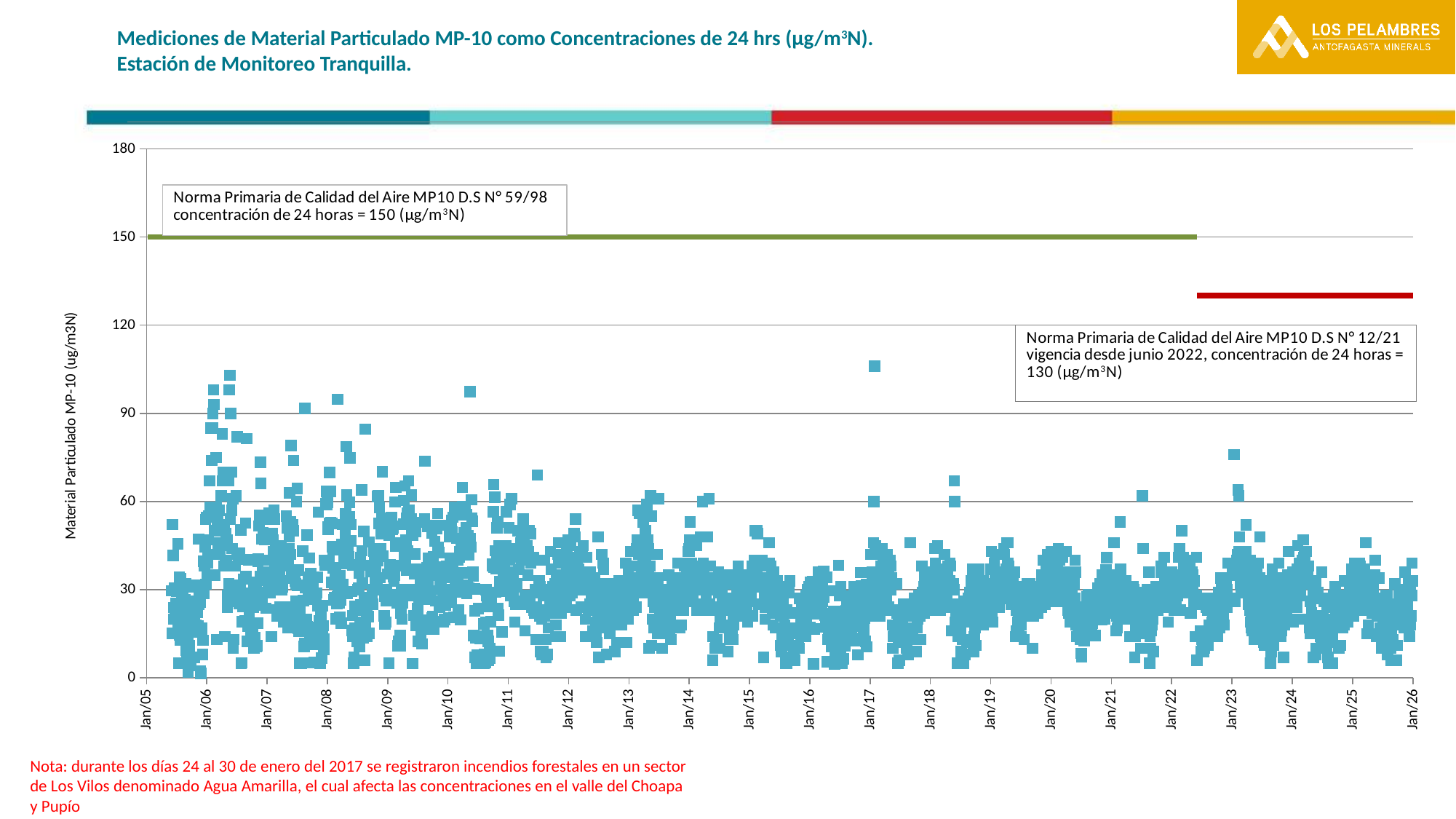
What is the 24-hour concentration limit set by the Norma Primaria de Calidad del Aire MP10 D.S N° 12/21, as stated on the chart? 130 (µg/m³N) How many year labels are shown on the x axis, from Jan/05 to Jan/26? 22 What is the difference between the D.S N° 59/98 limit and the D.S N° 12/21 limit shown on the chart? 20 (µg/m³N) Which monitoring station does the chart title refer to? Estación de Monitoreo Tranquilla Do any of the plotted measurements exceed the 150 limit line? No Is the highest measured value near Jan/17 greater or less than 120? less Since when has the D.S N° 12/21 standard been in force, according to the chart annotation? junio 2022 Is the highest measured value near Jan/17 greater or less than 90? greater Which limit line is higher on the chart, the D.S N° 59/98 line or the D.S N° 12/21 line? D.S N° 59/98 What is the maximum value shown on the y axis? 180 What kind of chart is shown on the slide? Scatter chart What is the 24-hour concentration limit set by the Norma Primaria de Calidad del Aire MP10 D.S N° 59/98, as stated on the chart? 150 (µg/m³N)